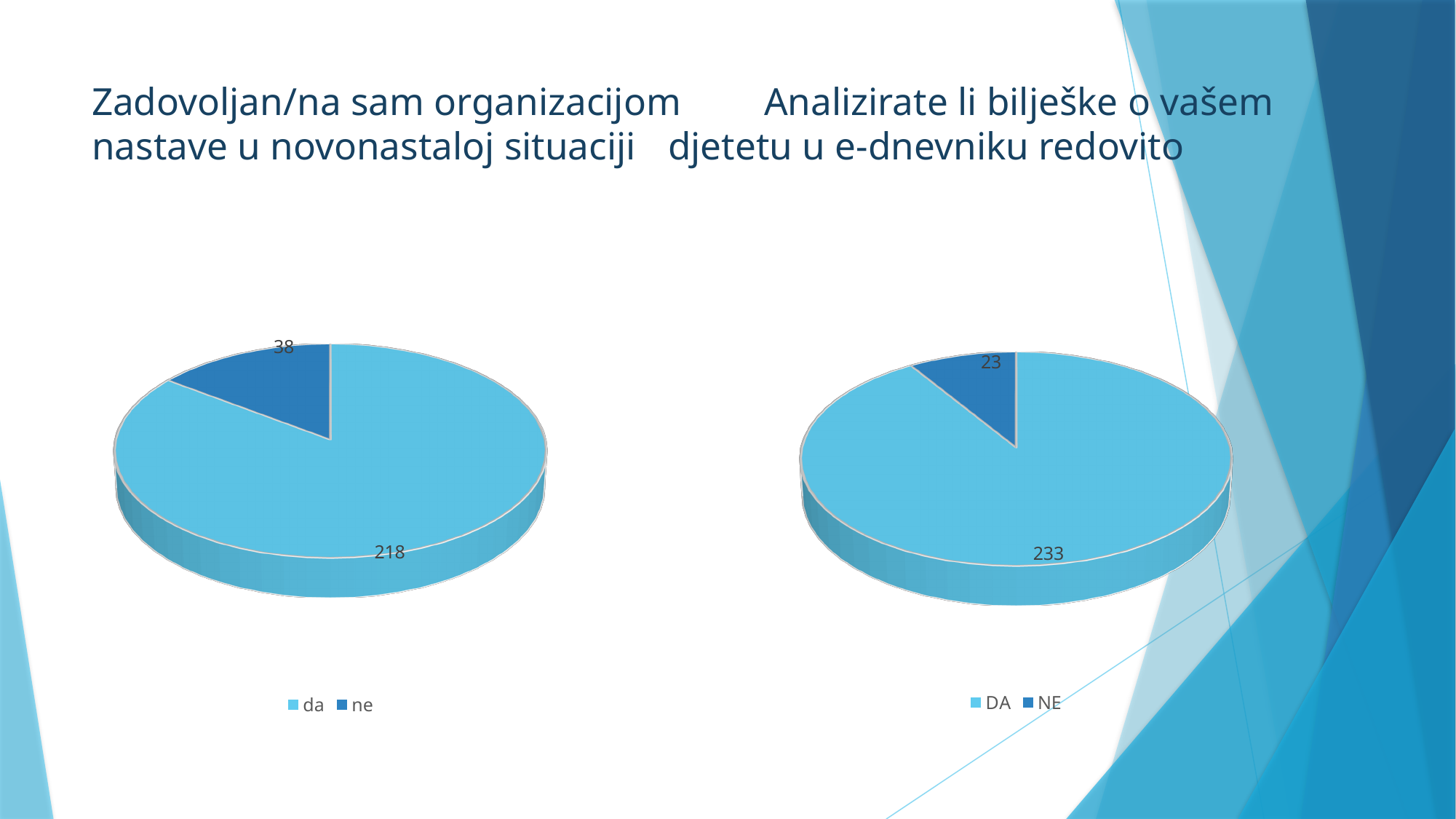
In the left pie chart, what is the difference between the 'da' and 'ne' values? 180 What are the legend entries of the right chart? DA, NE How many slices does the right pie chart have? 2 In the right pie chart, which category has the smallest slice? NE What type of chart is used on the left side of the slide? Pie chart In the left pie chart (Zadovoljan/na sam organizacijom nastave u novonastaloj situaciji), what is the value for 'da'? 218 In the right pie chart (Analizirate li bilješke o vašem djetetu u e-dnevniku redovito), what is the value for 'DA'? 233 Which is larger: the 'ne' value in the left pie chart or the 'NE' value in the right pie chart? 'ne' in the left chart (38) In the left pie chart (Zadovoljan/na sam organizacijom nastave u novonastaloj situaciji), what is the value for 'ne'? 38 In the left pie chart, which category has the largest slice? da In the right pie chart, what is the difference between the 'DA' and 'NE' values? 210 In the right pie chart (Analizirate li bilješke o vašem djetetu u e-dnevniku redovito), what is the value for 'NE'? 23